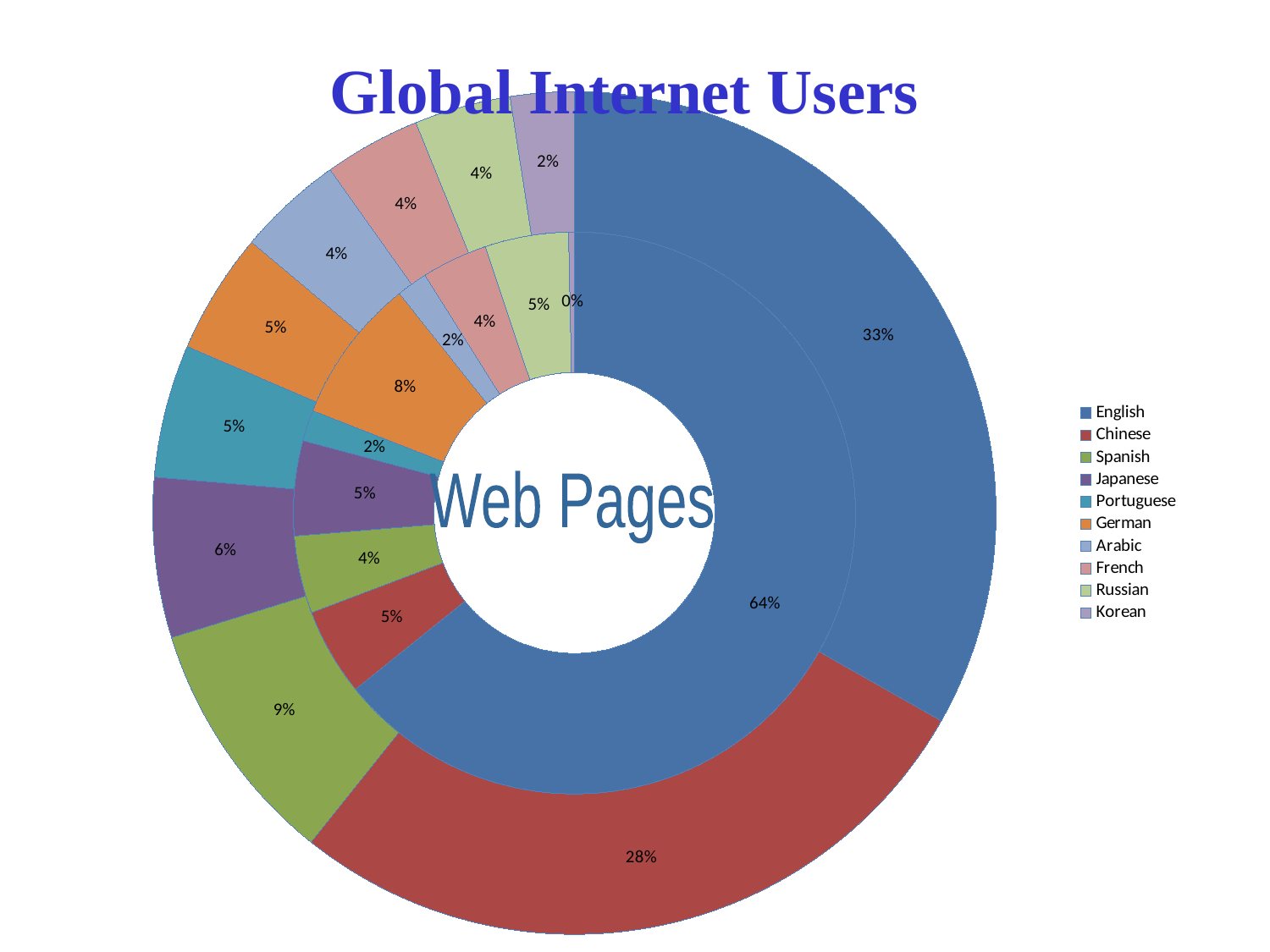
Which language has the largest share in the outer ring (Global Internet Users)? English In the inner ring (Web Pages), what percentage is shown for German? 8% In the outer ring (Global Internet Users), what percentage is shown for Spanish? 9% What is the difference between the English and Chinese shares in the outer ring (Global Internet Users)? 5% What is the title of the chart? Global Internet Users What kind of chart is shown on the slide? Doughnut chart How many languages does the legend list? 10 In the inner ring (Web Pages), what percentage is shown for English? 64% In the outer ring (Global Internet Users), what percentage is shown for English? 33% In the outer ring (Global Internet Users), which is larger, the share for Spanish or the share for Japanese? Spanish In the outer ring (Global Internet Users), what percentage is shown for Chinese? 28% Which language has the smallest share in the inner ring (Web Pages)? Korean